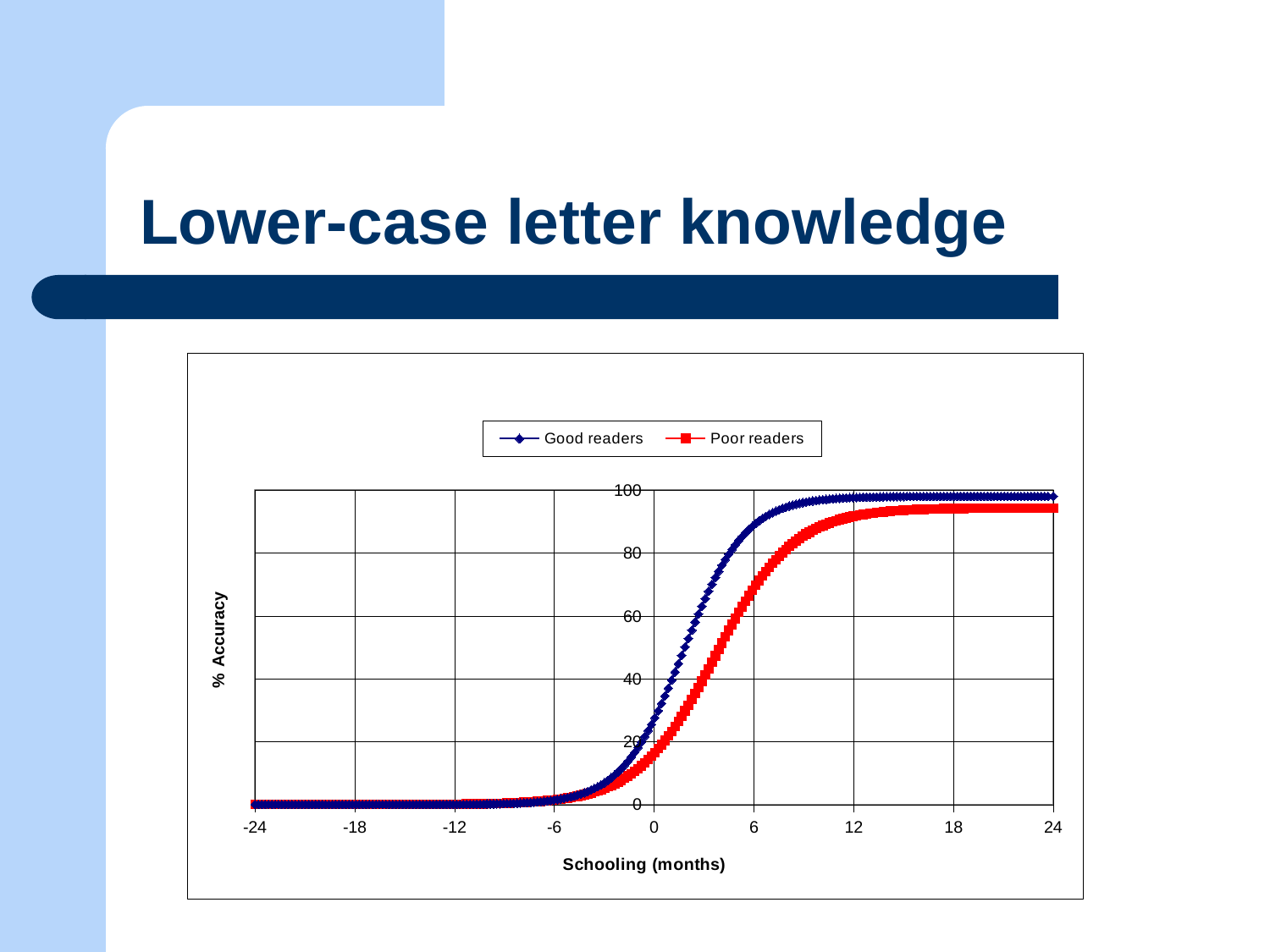
Is the value for Poor readers at -12 months greater or less than 20? less Is the value for Good readers at 6 months greater or less than 80? greater Do the values for Good readers rise or fall as schooling months increase from -24 to 24? rise At 24 months of schooling, which series has the higher % Accuracy, Good readers or Poor readers? Good readers What kind of chart is shown on the slide? line chart What are the two series named in the legend? Good readers and Poor readers Is the value for Poor readers at 6 months greater or less than 60? greater At 6 months of schooling, which series has the higher % Accuracy, Good readers or Poor readers? Good readers Do the values for Poor readers rise or fall as schooling months increase from 0 to 12? rise What is the label of the x axis? Schooling (months) How many series does the legend list? 2